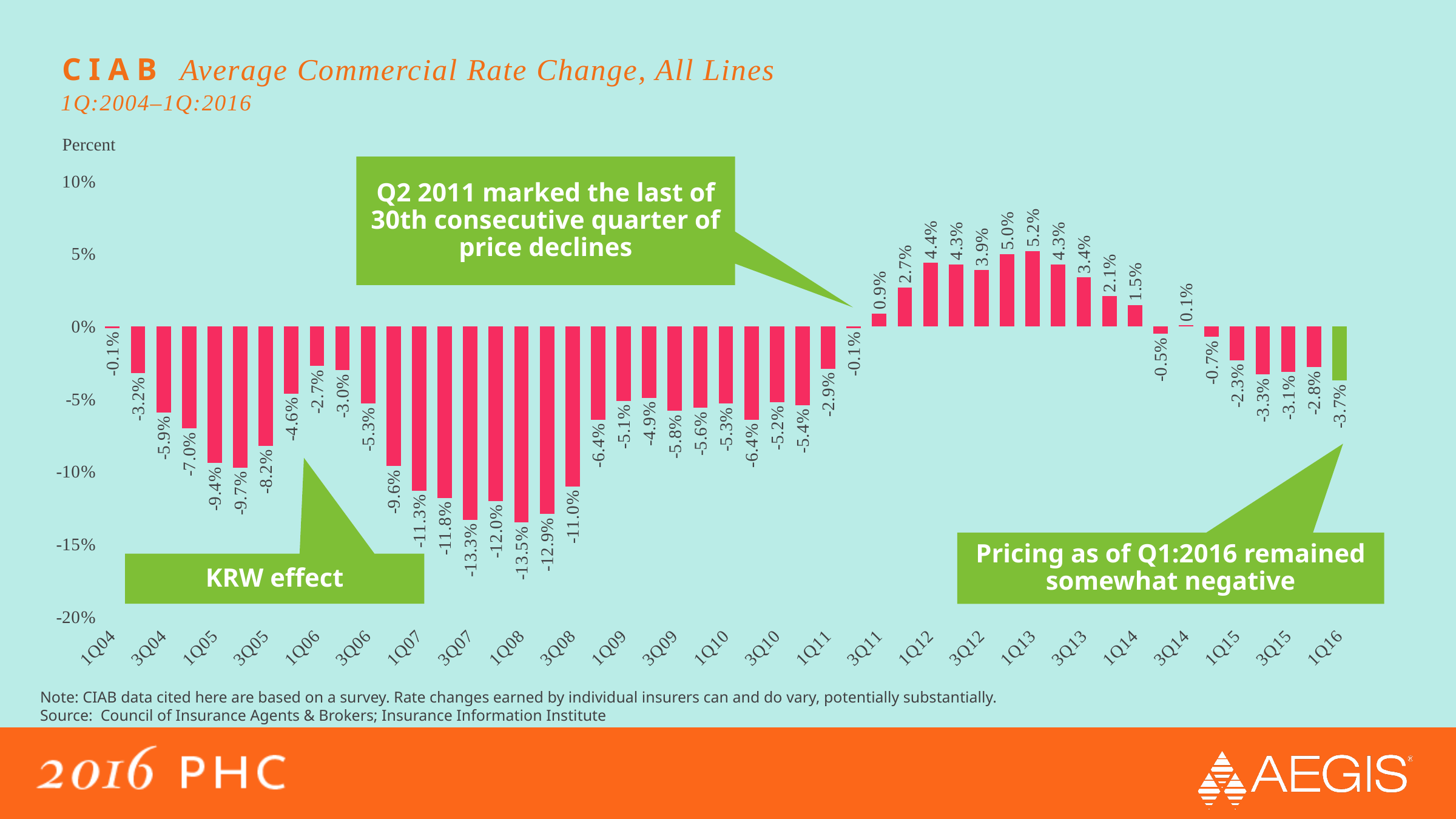
What is the difference in percentage points between the values for 1Q12 and 1Q16? 8.1 percentage points What is the value shown for 3Q14? 0.1% What is the average commercial rate change shown for 1Q16? -3.7% Do the values rise or fall from 1Q13 to 1Q16? Fall What is the value shown for 1Q05? -9.4% Which quarter has the lowest average commercial rate change? 1Q08 How many quarterly bars are plotted in the chart? 49 Which quarter has the highest average commercial rate change? 1Q13 What kind of chart is shown on the slide? Bar chart What is the value shown for 1Q13? 5.2% Which is larger, the value for 3Q07 or the value for 3Q08? 3Q08 What colour is the bar for 1Q16? Green